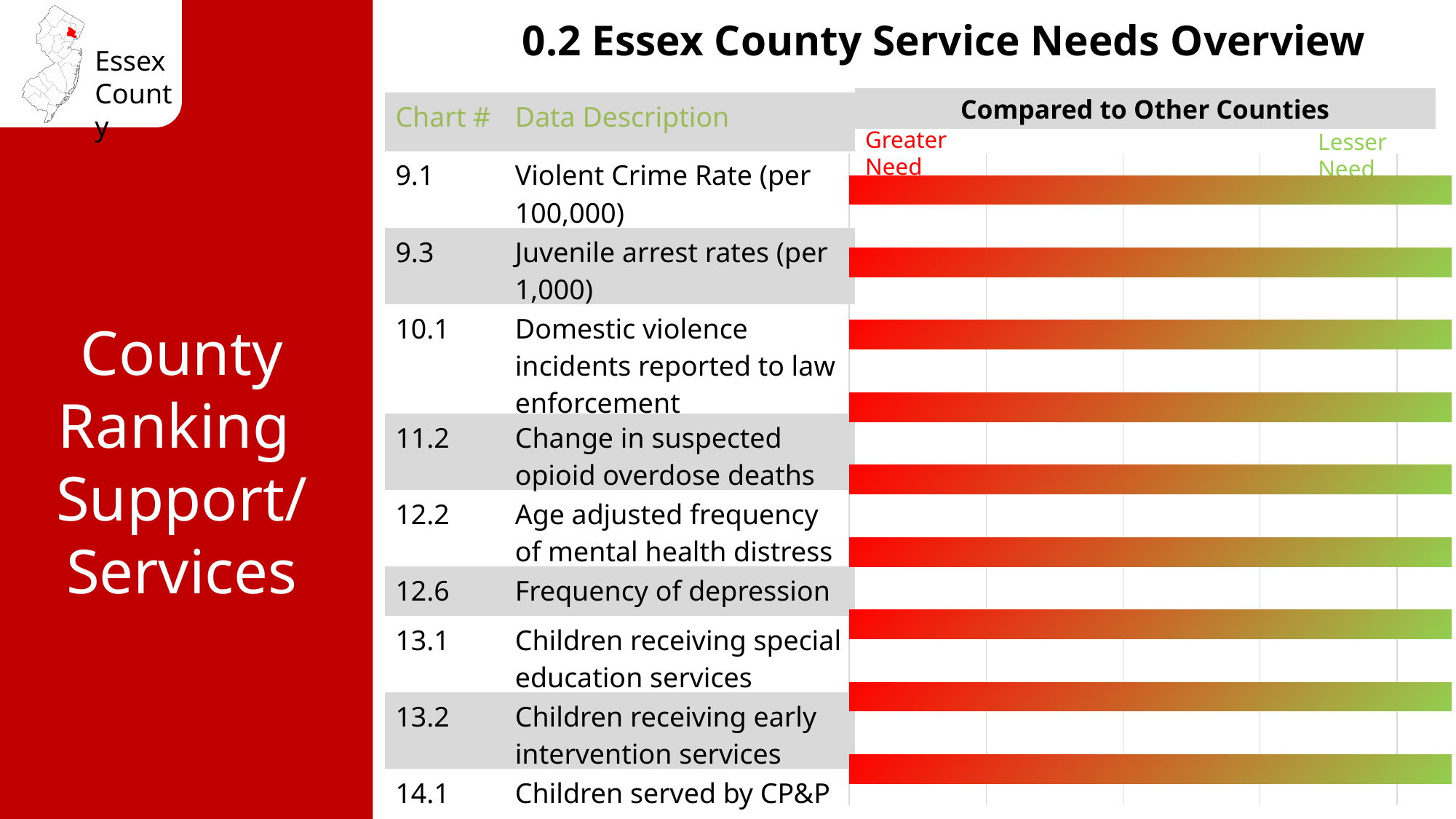
What kind of chart is shown under "Compared to Other Counties"? Bar chart What is the chart number listed for "Frequency of depression"? 12.6 How many bars are plotted in the "Compared to Other Counties" chart? 9 Which data description is listed for chart number 9.3? Juvenile arrest rates (per 1,000) Are the bars in the chart oriented horizontally or vertically? Horizontally What is the chart number listed for "Children served by CP&P"? 14.1 Which label appears at the left end of the chart's scale? Greater Need Which label appears at the right end of the chart's scale? Lesser Need What is the title above the bar chart? Compared to Other Counties How many data descriptions are listed in the table alongside the chart? 9